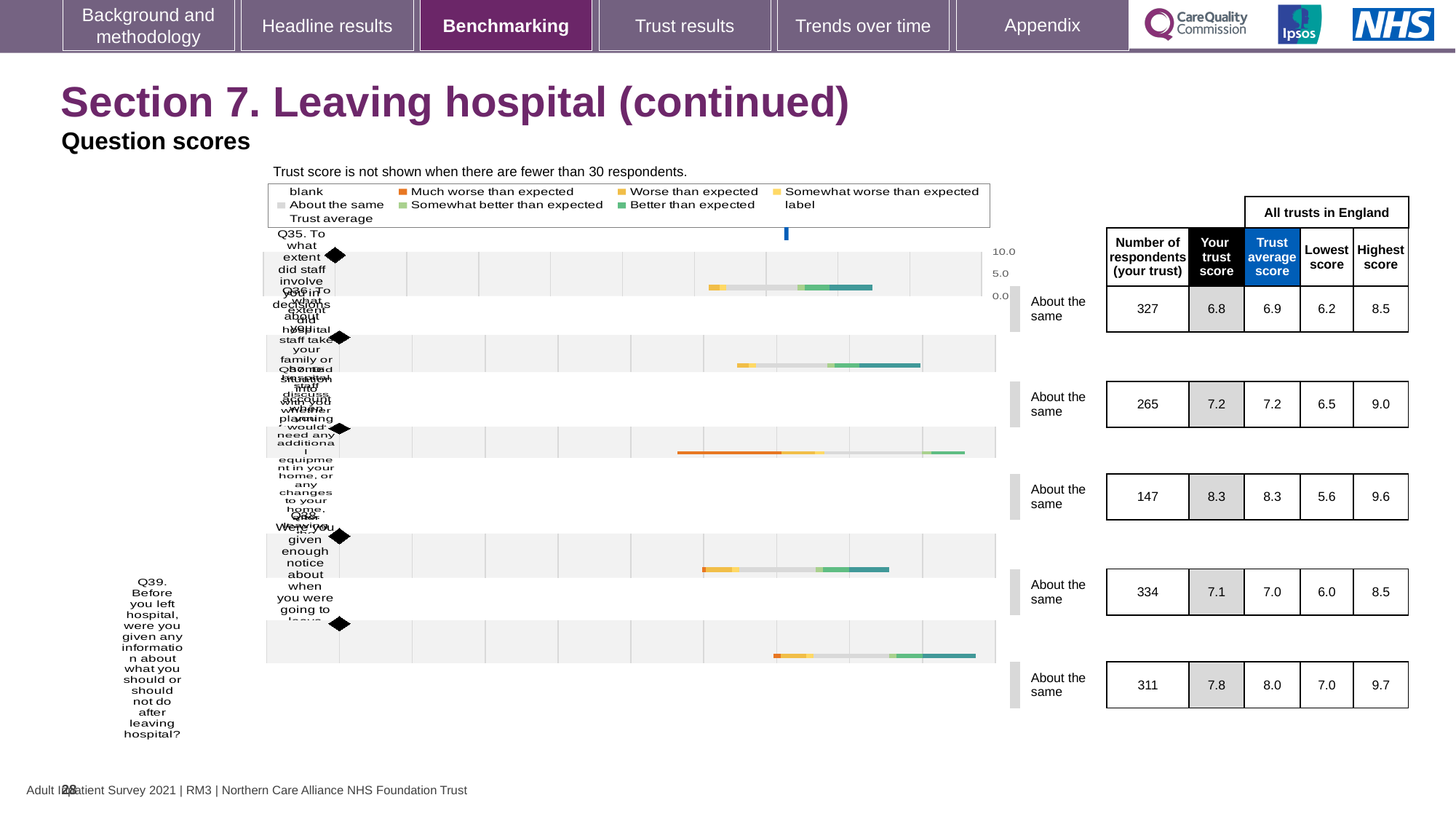
What is the maximum value shown on the chart's score axis? 10.0 Which question has the lowest number of respondents? Q37 How many questions (bars) are plotted in the benchmarking chart? 5 How many respondents from your trust answered Q37? 147 What kind of chart is used to show the question scores on this slide? bar chart What is the lowest score among all trusts in England for Q37? 5.6 For Q39, what is the difference between the trust average score (8.0) and your trust score (7.8)? 0.2 Which question has the highest 'Your trust score' in the table? Q37 What benchmark category label is shown next to each question's bar? About the same What is the 'Your trust score' for Q39 (information about what you should or should not do after leaving hospital)? 7.8 For Q38, which is larger: your trust score or the trust average score? Your trust score What is the highest score among all trusts in England for Q36? 9.0